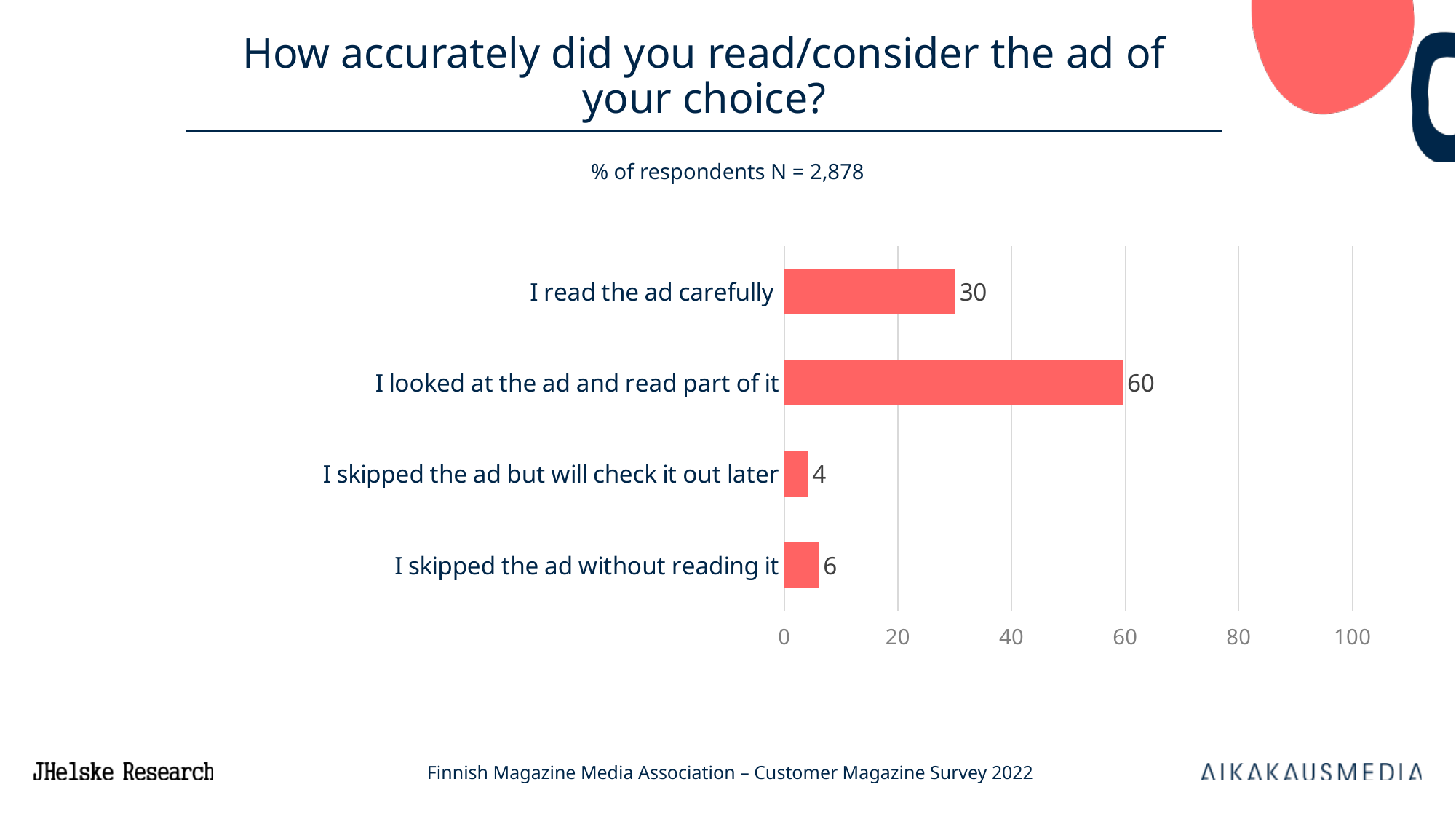
What value is shown for "I skipped the ad but will check it out later"? 4 What value is shown for "I looked at the ad and read part of it"? 60 What percentage of respondents said "I read the ad carefully"? 30 Is the value for "I read the ad carefully" greater or less than 40? less How many response categories are shown in the chart? 4 What is the number of respondents (N) stated on the slide? 2,878 Which response has the lowest value? I skipped the ad but will check it out later Which response has the highest value? I looked at the ad and read part of it What kind of chart is shown on the slide? bar chart What is the difference between "I looked at the ad and read part of it" and "I read the ad carefully"? 30 Which is larger: "I skipped the ad without reading it" or "I skipped the ad but will check it out later"? I skipped the ad without reading it What value is shown for "I skipped the ad without reading it"? 6